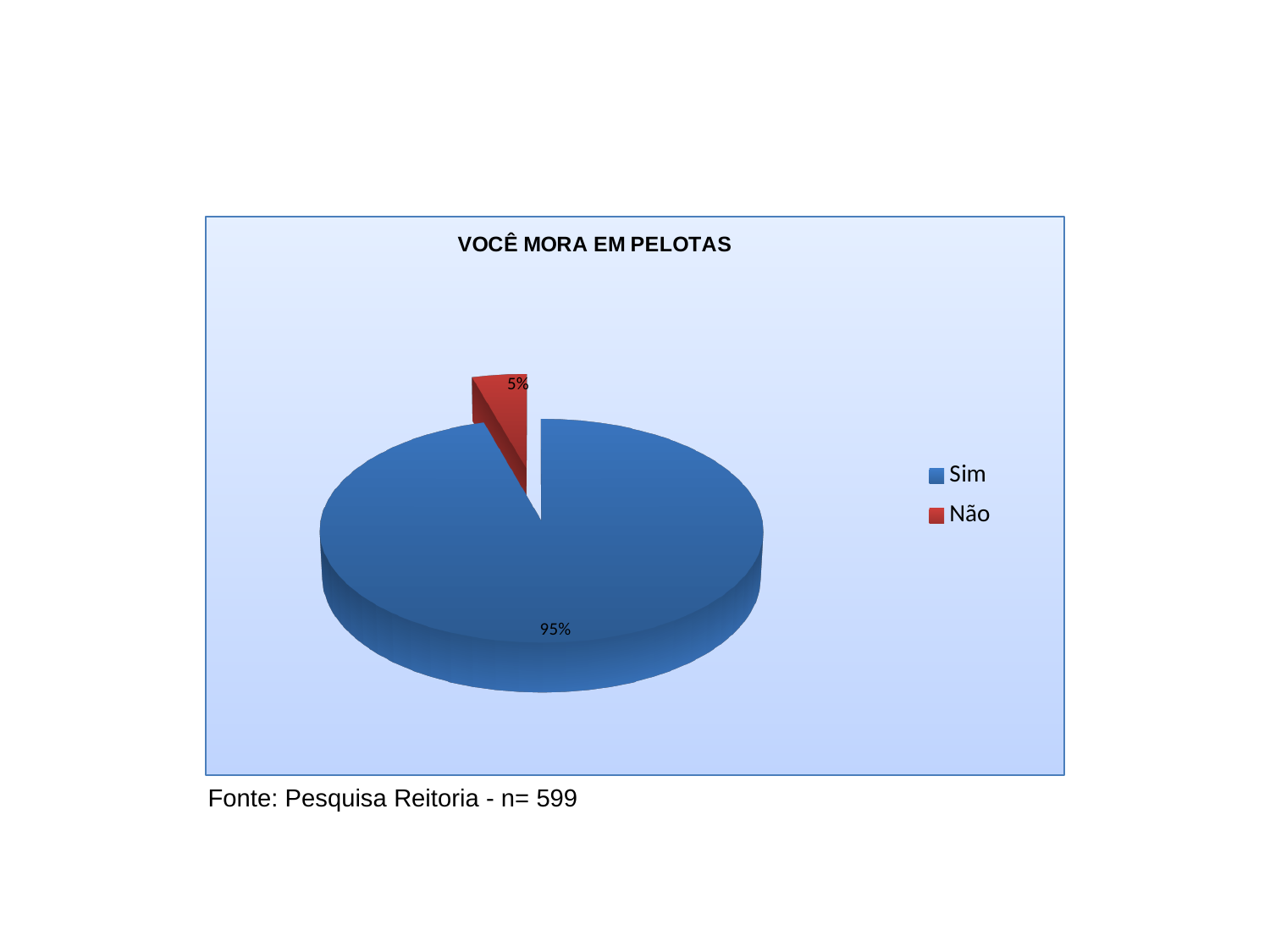
What is the difference in percentage points between the "Sim" and "Não" slices? 90 What type of chart is shown on the slide? Pie chart What percentage of the pie is labelled for "Sim"? 95% What percentage of the pie is labelled for "Não"? 5% Which is larger, the share for "Sim" or the share for "Não"? Sim How many categories does the legend list? 2 What is the title of the chart? VOCÊ MORA EM PELOTAS What colour is the "Não" slice in the pie chart? Red Which category has the largest share of the pie? Sim Which category has the smallest share of the pie? Não How many slices does the pie chart have? 2 What is the sample size (n) stated in the source note below the chart? 599